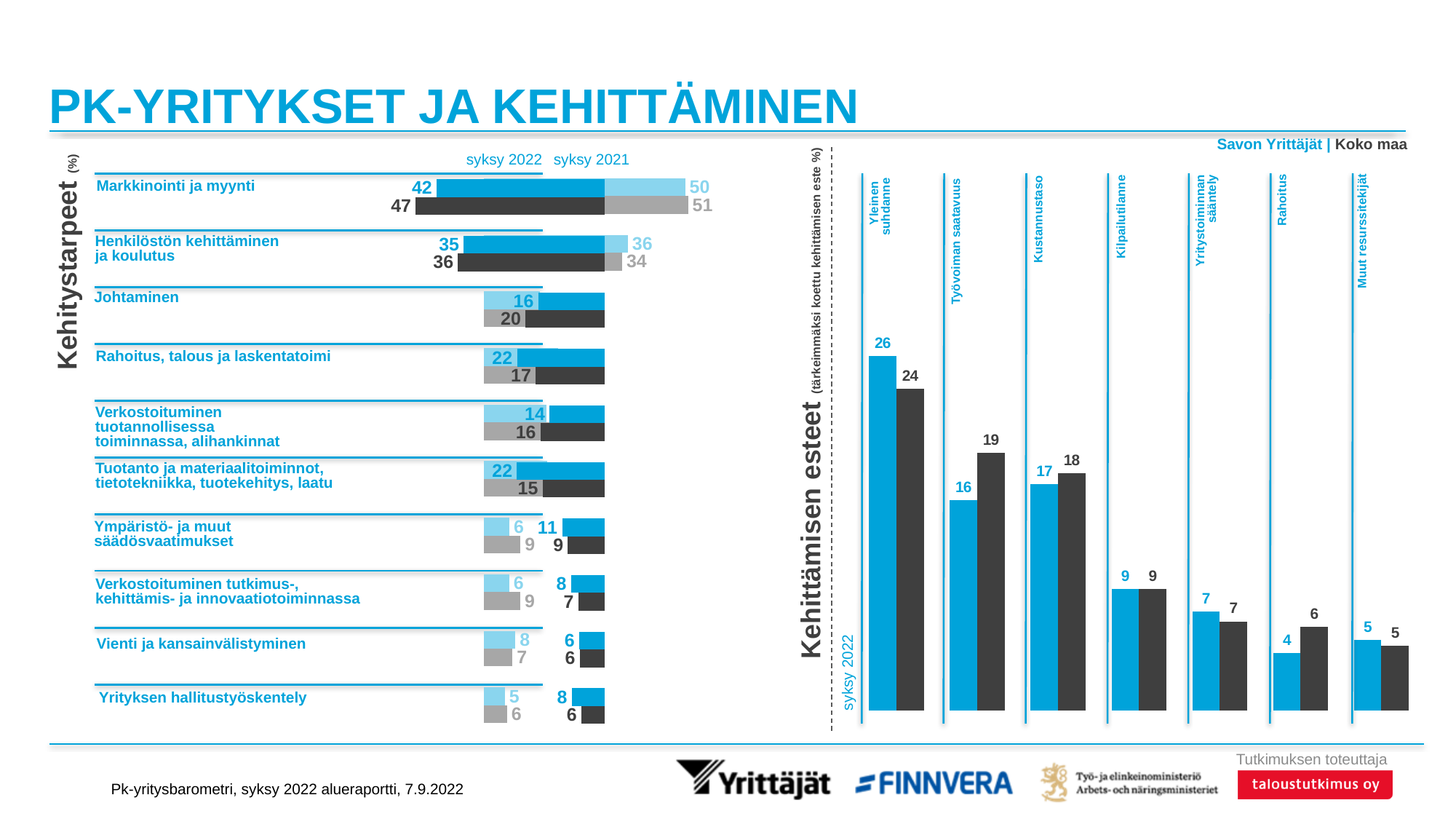
In the Kehitystarpeet chart on the left, what is the syksy 2022 value for Markkinointi ja myynti for Savon Yrittäjät? 42 In the Kehittämisen esteet chart on the right, which category has the highest value for Savon Yrittäjät? Yleinen suhdanne In the Kehitystarpeet chart on the left, what is the difference between the syksy 2022 Koko maa and Savon Yrittäjät values for Markkinointi ja myynti? 5 In the Kehittämisen esteet chart on the right, is the Savon Yrittäjät value for Työvoiman saatavuus larger or smaller than the Koko maa value? smaller In the Kehittämisen esteet chart on the right, what is the value for Savon Yrittäjät for Yleinen suhdanne? 26 How many categories are shown in the Kehittämisen esteet chart on the right? 7 In the Kehittämisen esteet chart on the right, what is the Koko maa value for Työvoiman saatavuus? 19 What kind of chart is the Kehittämisen esteet chart on the right? bar chart In the Kehittämisen esteet chart on the right, what is the difference between the Koko maa and Savon Yrittäjät values for Rahoitus? 2 In the Kehittämisen esteet chart on the right, which category has the lowest value for Savon Yrittäjät? Rahoitus Which two regions are compared in the charts, according to the legend at the top right? Savon Yrittäjät and Koko maa In the Kehitystarpeet chart on the left, what is the syksy 2021 Koko maa value for Markkinointi ja myynti? 51